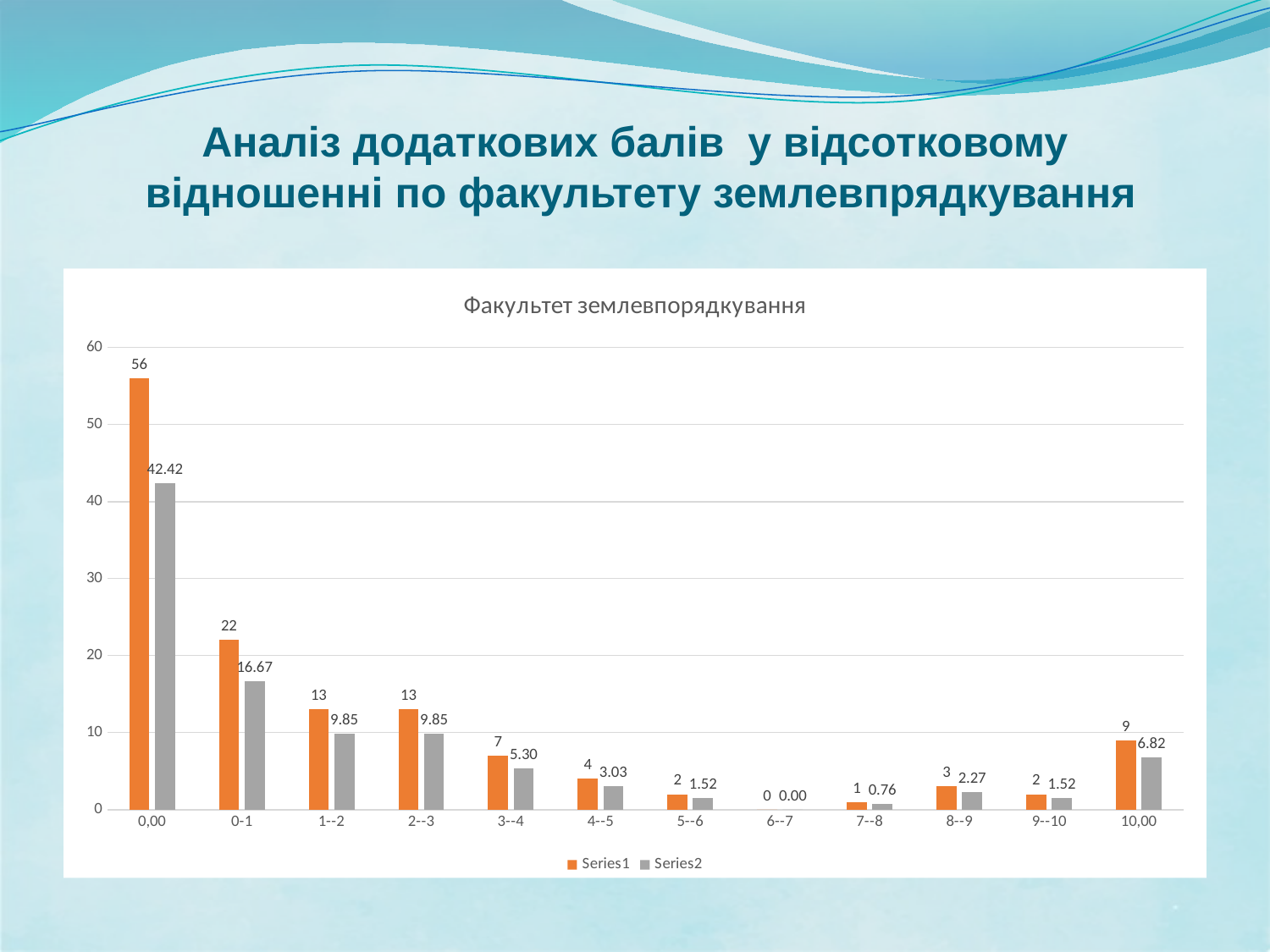
What is the difference between the Series1 values for 0,00 and 0-1? 34 What kind of chart is shown on the slide? bar chart Is the Series2 value for 0,00 greater or less than 40? greater What is the Series2 value for the category 0-1? 16.67 Which category has the lowest Series2 value? 6--7 What is the Series2 value for the category 10,00? 6.82 How many categories are shown on the x axis? 12 Which category has the highest Series1 value? 0,00 What is the title of the chart? Факультет землевпорядкування Which is larger, the Series1 value for 3--4 or the Series1 value for 10,00? 10,00 How many series does the legend list? 2 What is the Series1 value for the category 0,00? 56